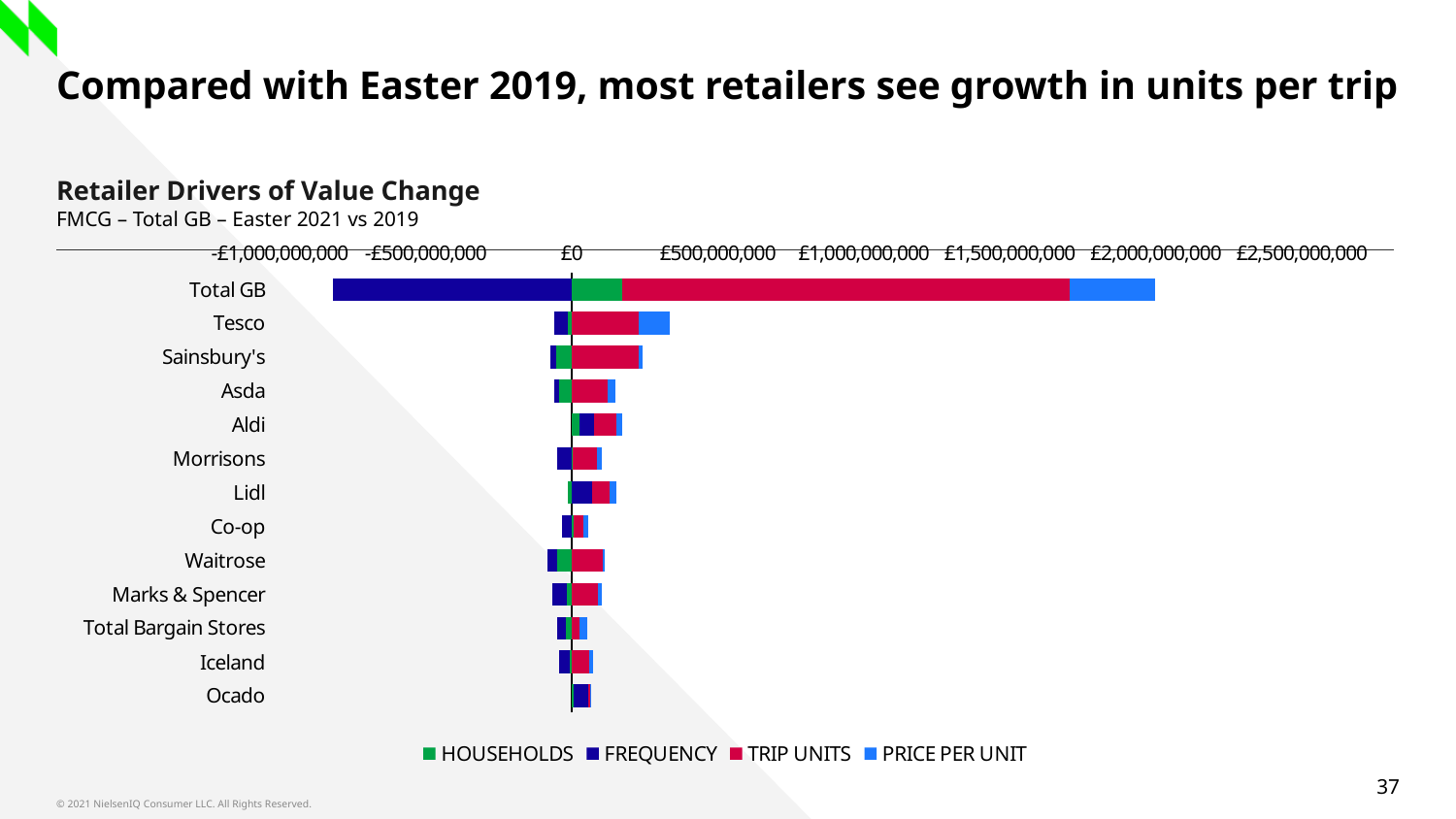
How many series does the legend list? 4 Is the PRICE PER UNIT value for Tesco greater or less than £500,000,000? less Which is larger, the TRIP UNITS value for Total GB or the TRIP UNITS value for Tesco? Total GB Is the FREQUENCY value for Total GB greater or less than -£500,000,000? less What is the title of the chart? Retailer Drivers of Value Change Which series is negative for Total GB? FREQUENCY How many retailer categories are plotted on the chart? 13 Which series makes the largest positive contribution for Total GB? TRIP UNITS Excluding Total GB, which retailer's bar extends furthest to the right? Tesco What kind of chart is shown on the slide? Stacked bar chart Is the TRIP UNITS value for Total GB greater or less than £1,000,000,000? greater Which series is shown in green in the legend? HOUSEHOLDS